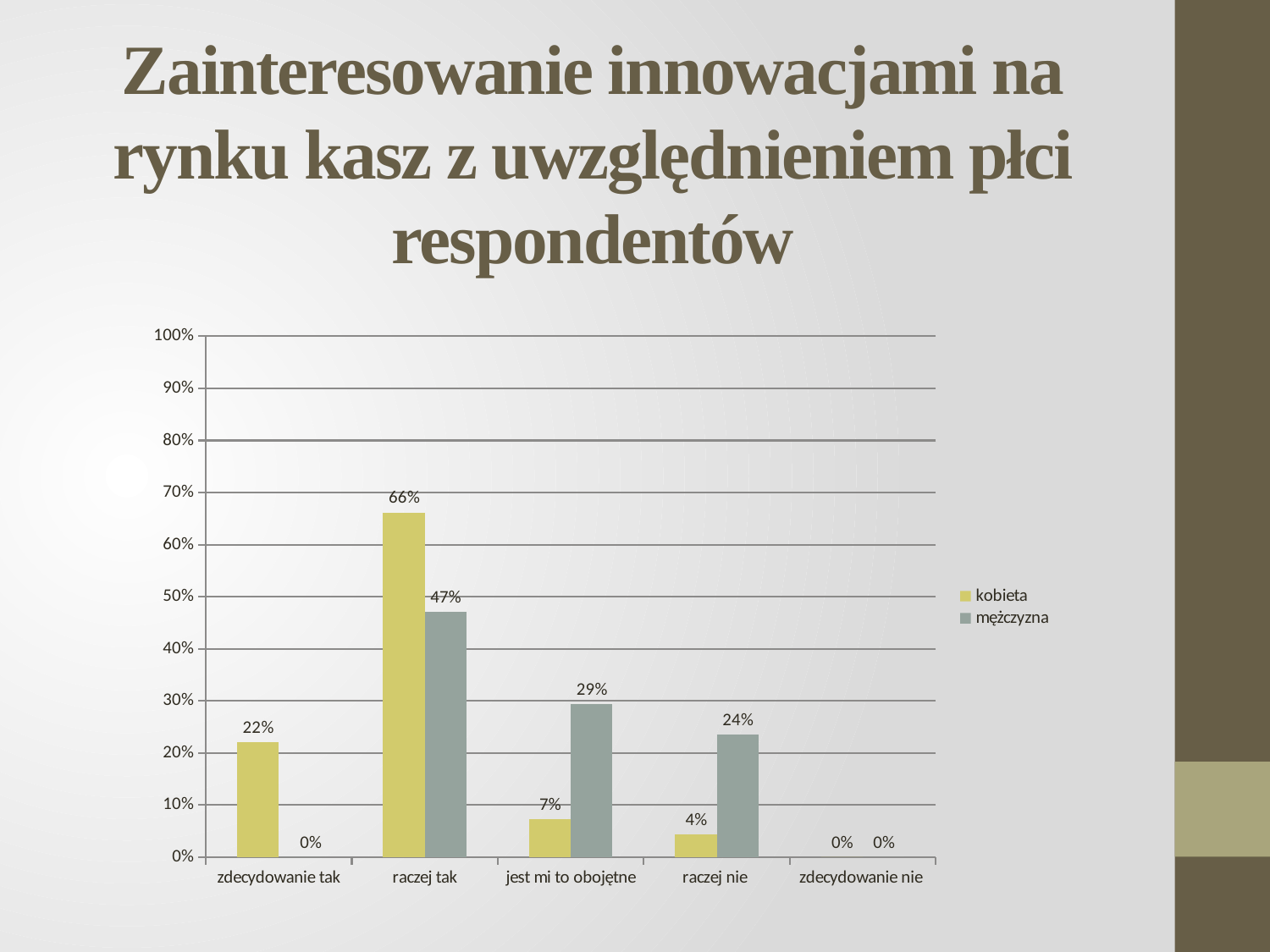
What is the value for kobieta in the 'raczej tak' category? 66% How many series does the legend list? 2 Which category has the highest value for kobieta? raczej tak What is the difference between the mężczyzna and kobieta values in the 'jest mi to obojętne' category? 22% Which category has the highest value for mężczyzna? raczej tak What is the value for mężczyzna in the 'zdecydowanie tak' category? 0% Is the value for kobieta in 'zdecydowanie tak' greater or less than 20%? greater What kind of chart is shown on the slide? bar chart What is the difference between the kobieta and mężczyzna values in the 'raczej tak' category? 19% What is the value for mężczyzna in the 'jest mi to obojętne' category? 29% How many categories are shown on the x axis? 5 In the 'raczej nie' category, which series has the larger value, kobieta or mężczyzna? mężczyzna